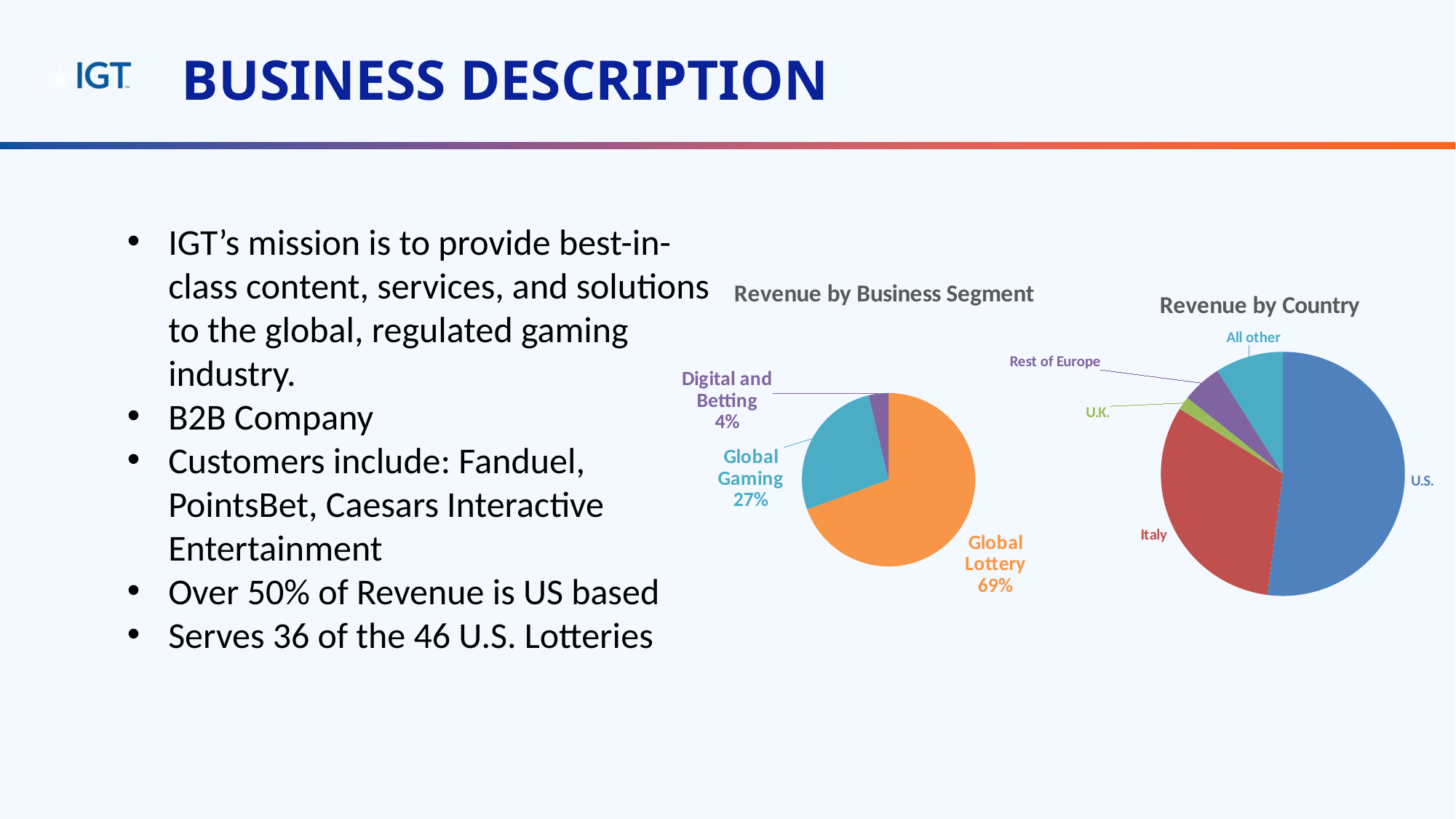
What is the title of the pie chart on the right side of the slide? Revenue by Country In the Revenue by Business Segment chart, which segment has the largest share? Global Lottery In the Revenue by Country chart, which is larger, the share for Italy or the share for U.K.? Italy In the Revenue by Country chart, which country has the largest share of revenue? U.S. In the Revenue by Business Segment chart, how many percentage points larger is Global Lottery than Global Gaming? 42 In the Revenue by Business Segment chart, what share of revenue comes from Global Gaming? 27% In the Revenue by Business Segment chart, what share of revenue comes from Global Lottery? 69% In the Revenue by Business Segment chart, which segment has the smallest share? Digital and Betting What kind of chart is the Revenue by Business Segment chart? Pie chart In the Revenue by Country chart, how many categories are shown? 5 In the Revenue by Business Segment chart, how many segments are shown? 3 In the Revenue by Business Segment chart, what share of revenue comes from Digital and Betting? 4%